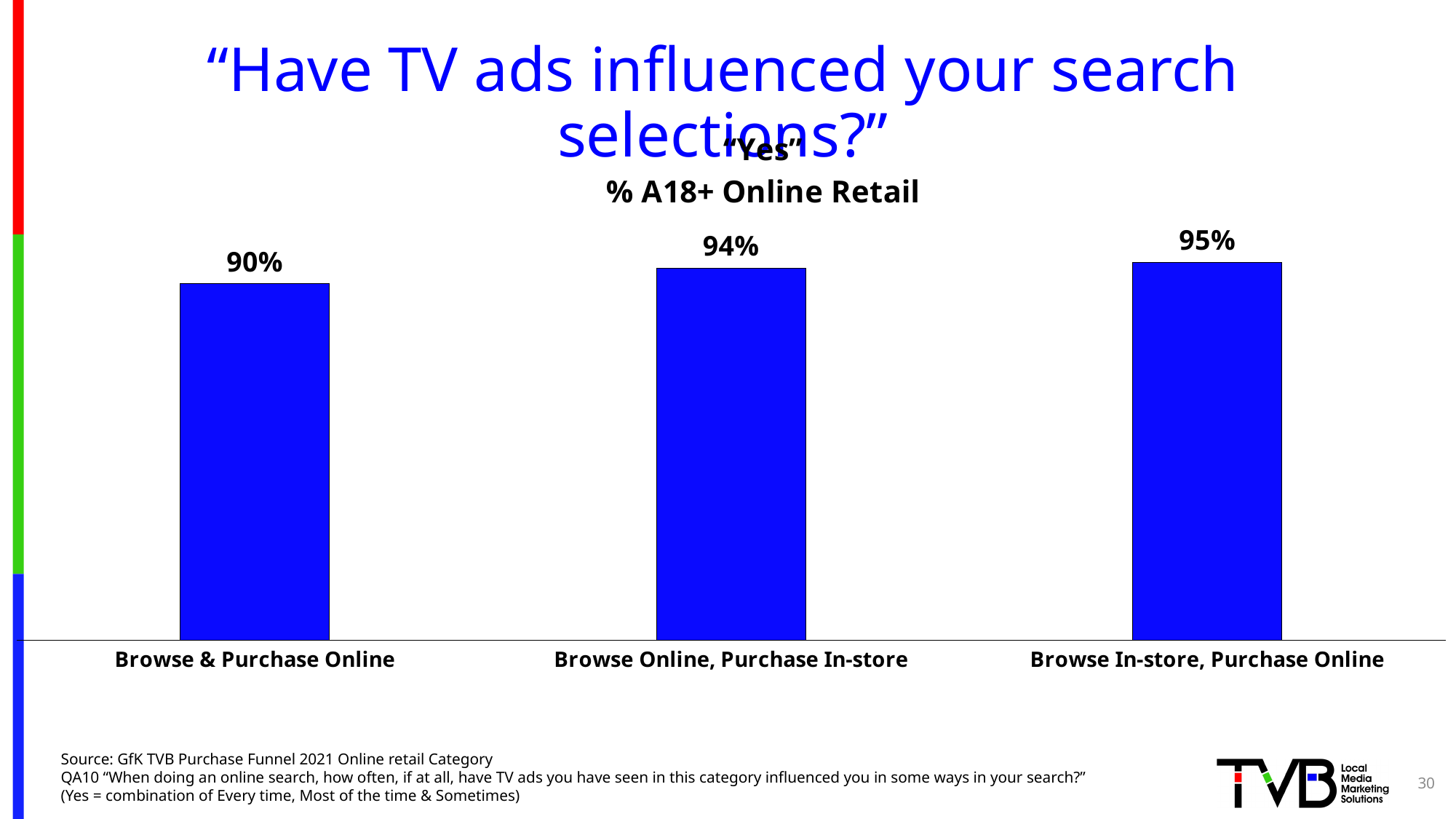
Which category has the lowest value? Browse & Purchase Online What is the subtitle shown below "Yes" above the chart? % A18+ Online Retail What is the difference between the values for Browse Online, Purchase In-store and Browse & Purchase Online? 4% How many categories are shown in the chart? 3 Do the values rise or fall from left to right across the categories? Rise Which category has the highest value? Browse In-store, Purchase Online What percentage is shown for Browse In-store, Purchase Online? 95% What is the difference between the values for Browse In-store, Purchase Online and Browse & Purchase Online? 5% What percentage is shown for Browse & Purchase Online? 90% What kind of chart is shown on the slide? Bar chart What percentage is shown for Browse Online, Purchase In-store? 94% Which is larger: the value for Browse Online, Purchase In-store or the value for Browse & Purchase Online? Browse Online, Purchase In-store